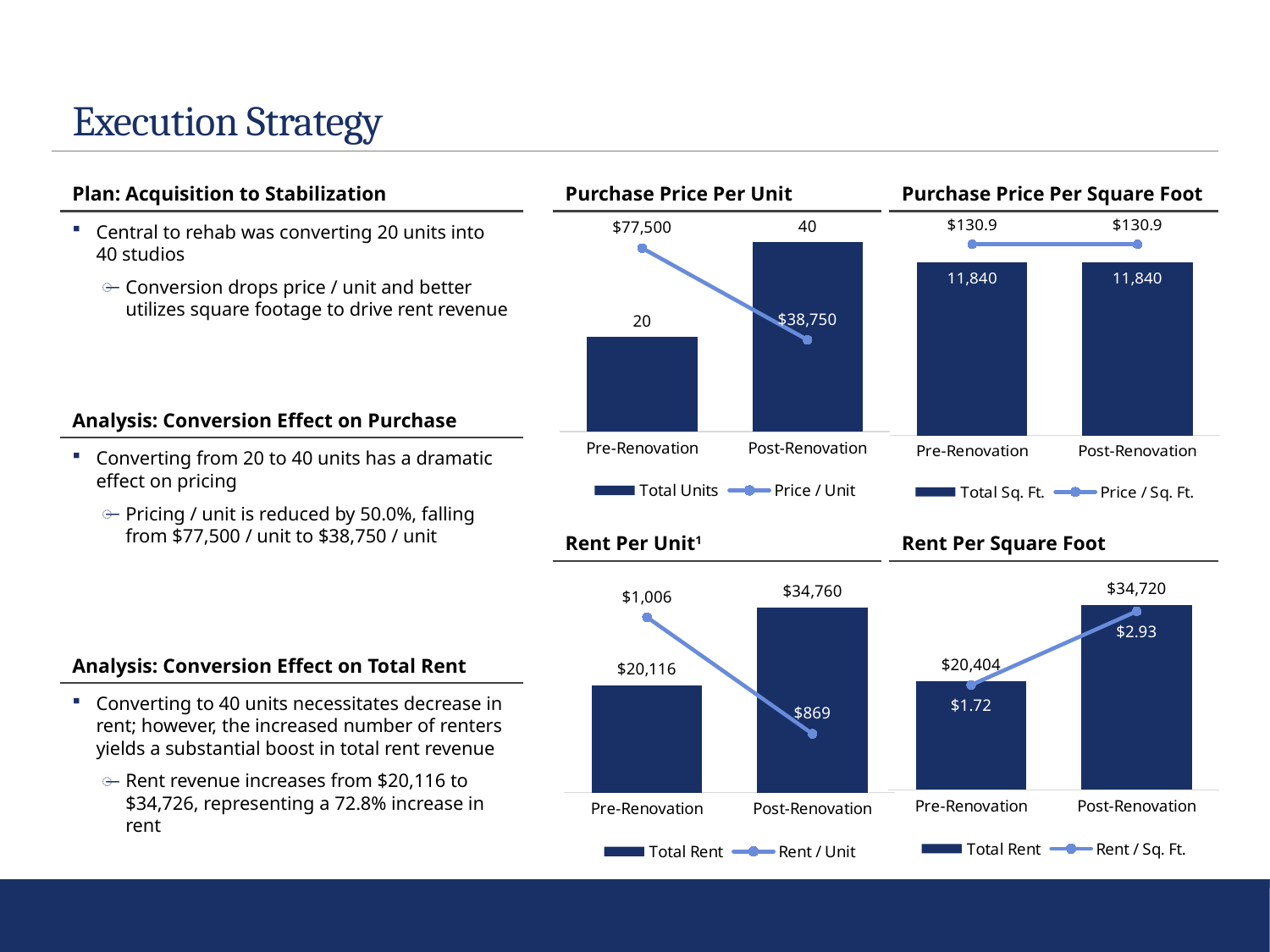
In the Purchase Price Per Square Foot chart, does the Price / Sq. Ft. rise, fall, or stay flat from Pre-Renovation to Post-Renovation? stay flat In the Rent Per Unit chart, what is the Rent / Unit for Post-Renovation? $869 In the Purchase Price Per Square Foot chart, what is the Total Sq. Ft. for Pre-Renovation? 11,840 How many series does the legend of the Rent Per Square Foot chart list? 2 In the Rent Per Unit chart, what is the Total Rent for Post-Renovation? $34,760 In the Purchase Price Per Unit chart, what is the Price / Unit for Pre-Renovation? $77,500 In the Rent Per Square Foot chart, what is the Rent / Sq. Ft. for Pre-Renovation? $1.72 In the Purchase Price Per Unit chart, what is the Total Units value for Post-Renovation? 40 In the Purchase Price Per Unit chart, what is the difference between the Pre-Renovation and Post-Renovation Price / Unit? $38,750 In the Purchase Price Per Square Foot chart, what is the Price / Sq. Ft. for Post-Renovation? $130.9 In the Rent Per Unit chart, which category has the higher Rent / Unit, Pre-Renovation or Post-Renovation? Pre-Renovation In the Rent Per Square Foot chart, what is the difference in Total Rent between Post-Renovation and Pre-Renovation? $14,316